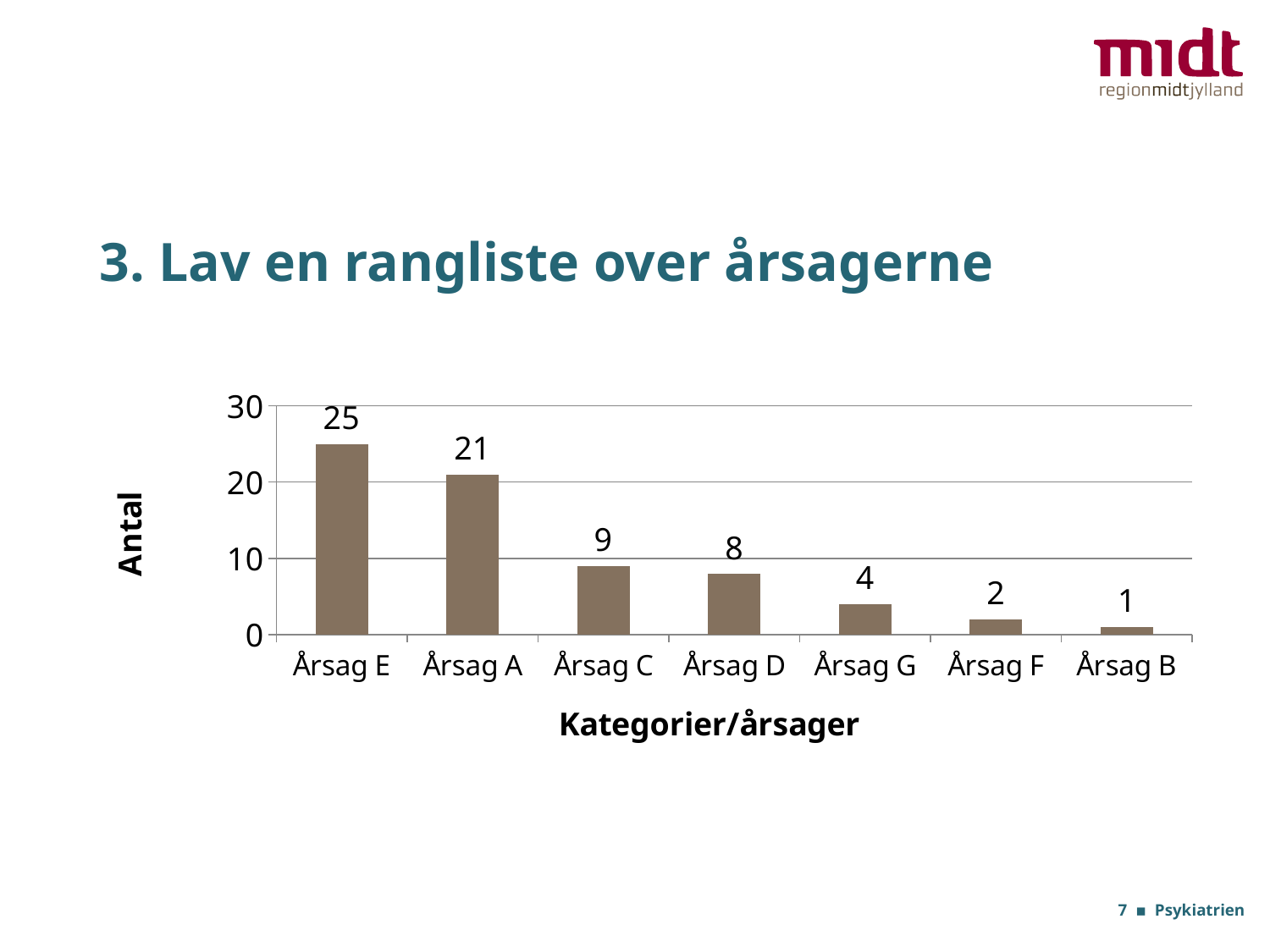
What is the difference between the values for Årsag C and Årsag G? 5 What is the value for Årsag F? 2 What is the value for Årsag E? 25 What is the difference between the values for Årsag E and Årsag A? 4 Is the value for Årsag A greater or less than 20? greater What is the value for Årsag C? 9 Which category has the lowest value? Årsag B Which is larger, the value for Årsag D or the value for Årsag G? Årsag D Which category has the highest value? Årsag E How many categories are shown on the x axis? 7 What kind of chart is shown on the slide? bar chart What is the label of the y axis? Antal